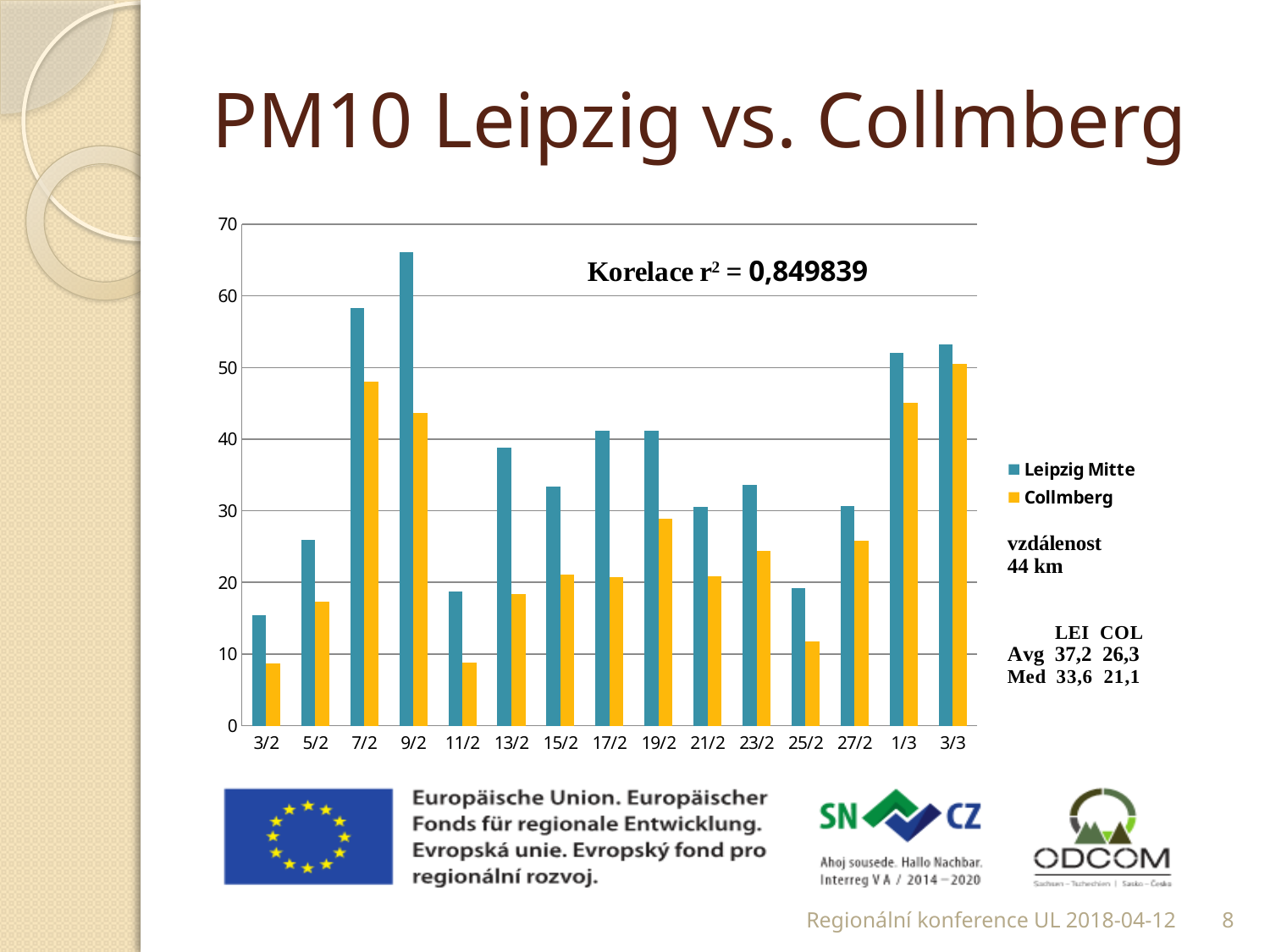
Is the Leipzig Mitte value for 9/2 greater or less than 60? greater How many dates are shown on the x axis? 15 What correlation r² value is printed on the chart? 0,849839 On which date is the Leipzig Mitte value highest? 9/2 On 3/2, which series has the larger value, Leipzig Mitte or Collmberg? Leipzig Mitte Is the Leipzig Mitte value for 11/2 greater or less than 20? less What type of chart is shown on the slide? bar chart How many series does the legend list? 2 Is the Collmberg value for 3/2 greater or less than 10? less On which date is the Leipzig Mitte value lowest? 3/2 Which is larger for Leipzig Mitte, the value on 7/2 or on 9/2? 9/2